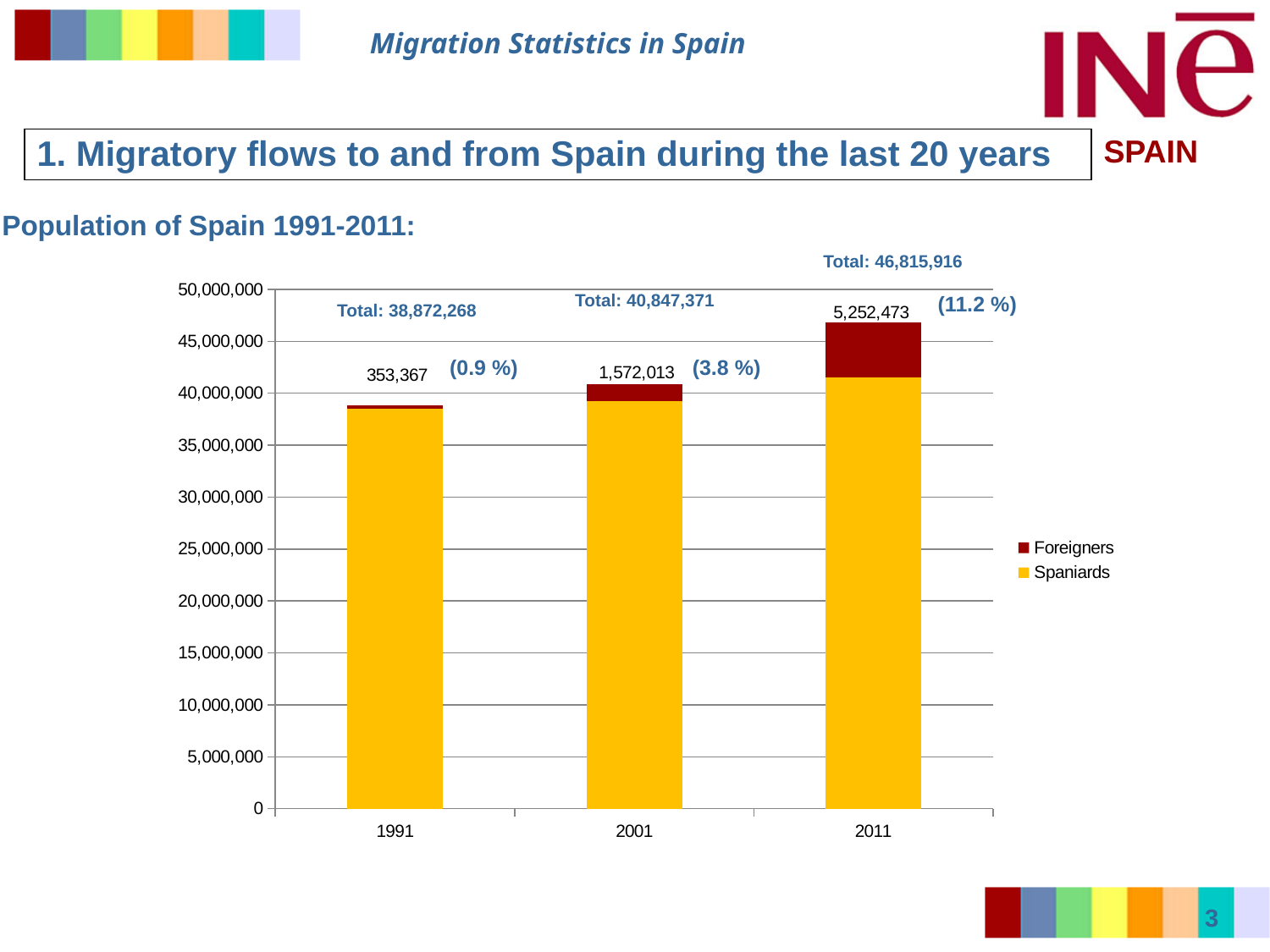
Which year has the highest number of Foreigners? 2011 What percentage of the population were Foreigners in 2001? 3.8 % What is the total population of Spain in 2001 according to the chart? 40,847,371 Which year has the lowest total population? 1991 What is the difference between the total population in 2011 and in 1991? 7,943,648 How many series does the legend list? 2 What is the number of Foreigners in 1991? 353,367 Does the total population rise or fall from 1991 to 2011? rise What is the difference in the number of Foreigners between 2011 and 1991? 4,899,106 Is the number of Spaniards in 2011 greater or less than 40,000,000? greater What is the total population of Spain in 2011 according to the chart? 46,815,916 What is the number of Foreigners in 2011? 5,252,473